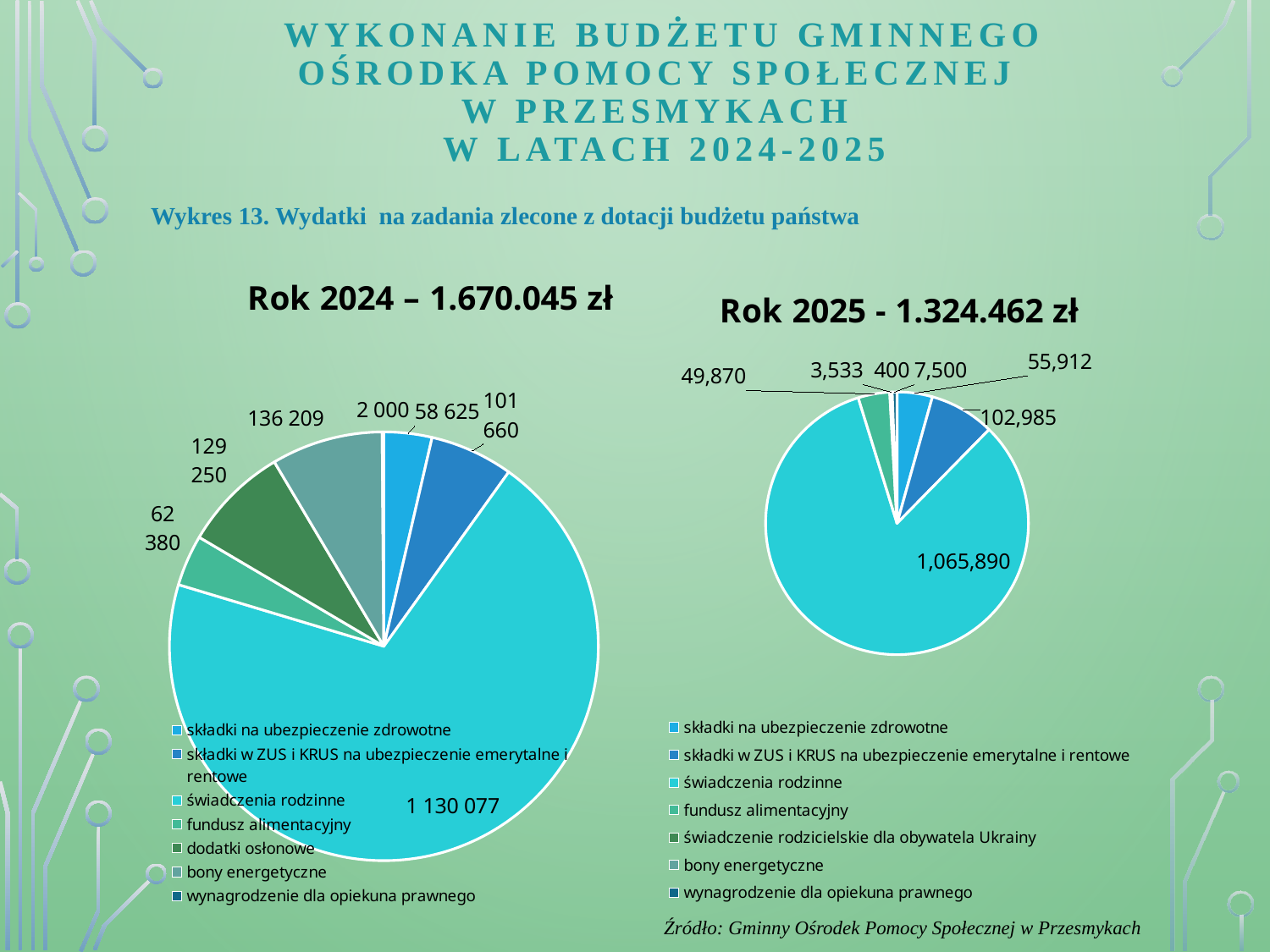
What total amount is given in the title of the 'Rok 2024' chart? 1.670.045 zł In the 'Rok 2025' chart, which category has the largest slice? świadczenia rodzinne In the 'Rok 2025' chart, what is the value of the largest slice? 1,065,890 How many categories does the legend of the 'Rok 2025' chart list? 7 In the 'Rok 2025' chart, what is the smallest labelled value? 400 In the 'Rok 2024' chart, what is the value of the largest slice? 1 130 077 In the 'Rok 2024' chart, what is the smallest labelled value? 2 000 In the 'Rok 2025' chart, what is the value for składki w ZUS i KRUS na ubezpieczenie emerytalne i rentowe? 102,985 Which is larger: the largest slice in the 'Rok 2024' chart or the largest slice in the 'Rok 2025' chart? Rok 2024 What total amount is given in the title of the 'Rok 2025' chart? 1.324.462 zł What type of chart is used for the 'Rok 2024' and 'Rok 2025' charts? pie chart